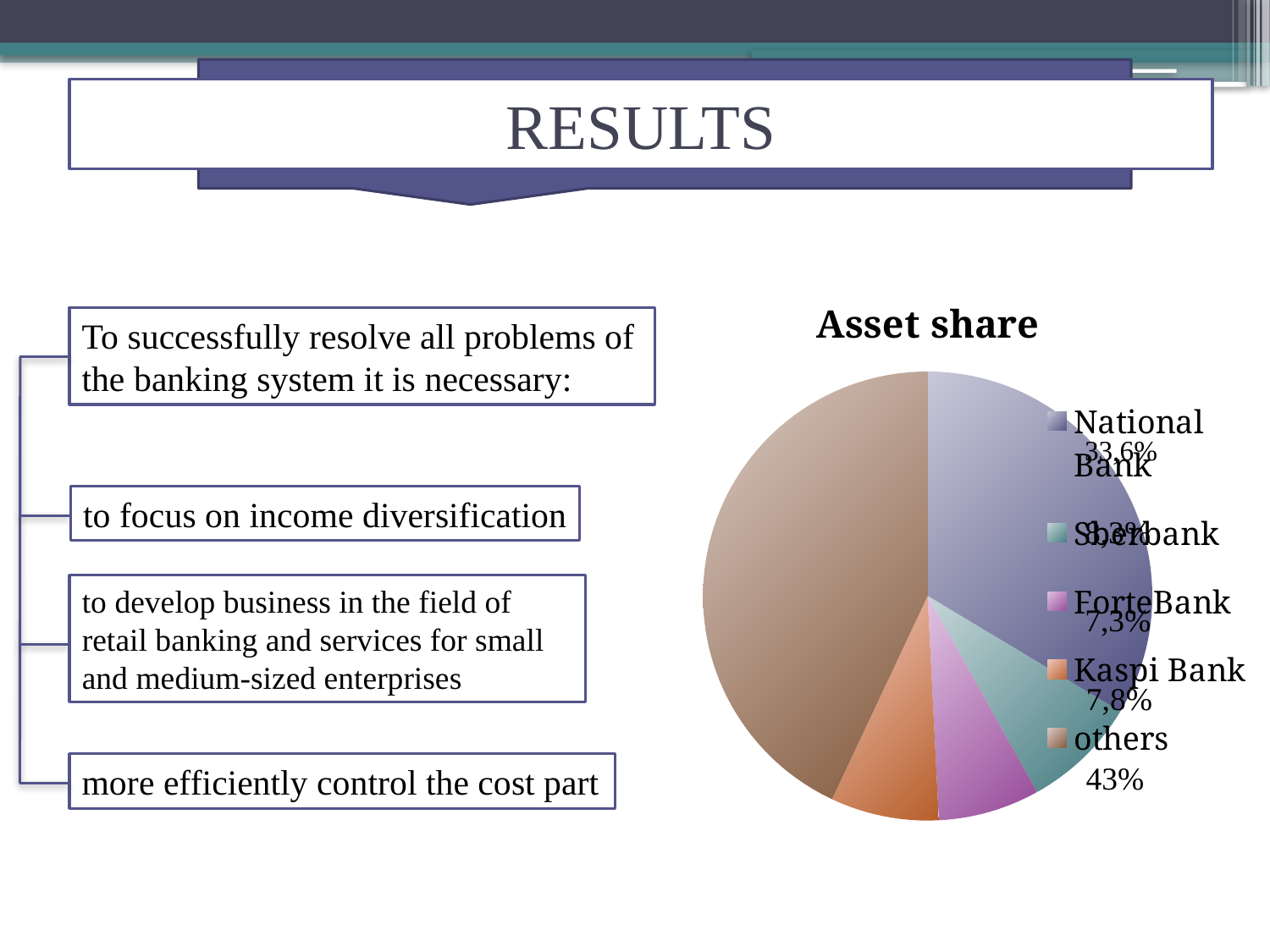
What is the asset share of National Bank? 33,6% Which category has the largest slice of the pie? others What share of assets does the 'others' slice represent? 43% Which is larger, the asset share of Kaspi Bank or of ForteBank? Kaspi Bank How many categories does the legend of the pie chart list? 5 What is the asset share of ForteBank? 7,3% What kind of chart is shown on the slide? pie chart Which named bank has the smallest asset share? ForteBank What is the difference between the asset share of 'others' and that of National Bank? 9,4% What is the title of the chart? Asset share What is the asset share of Kaspi Bank? 7,8% Which is larger, the asset share of National Bank or of 'others'? others